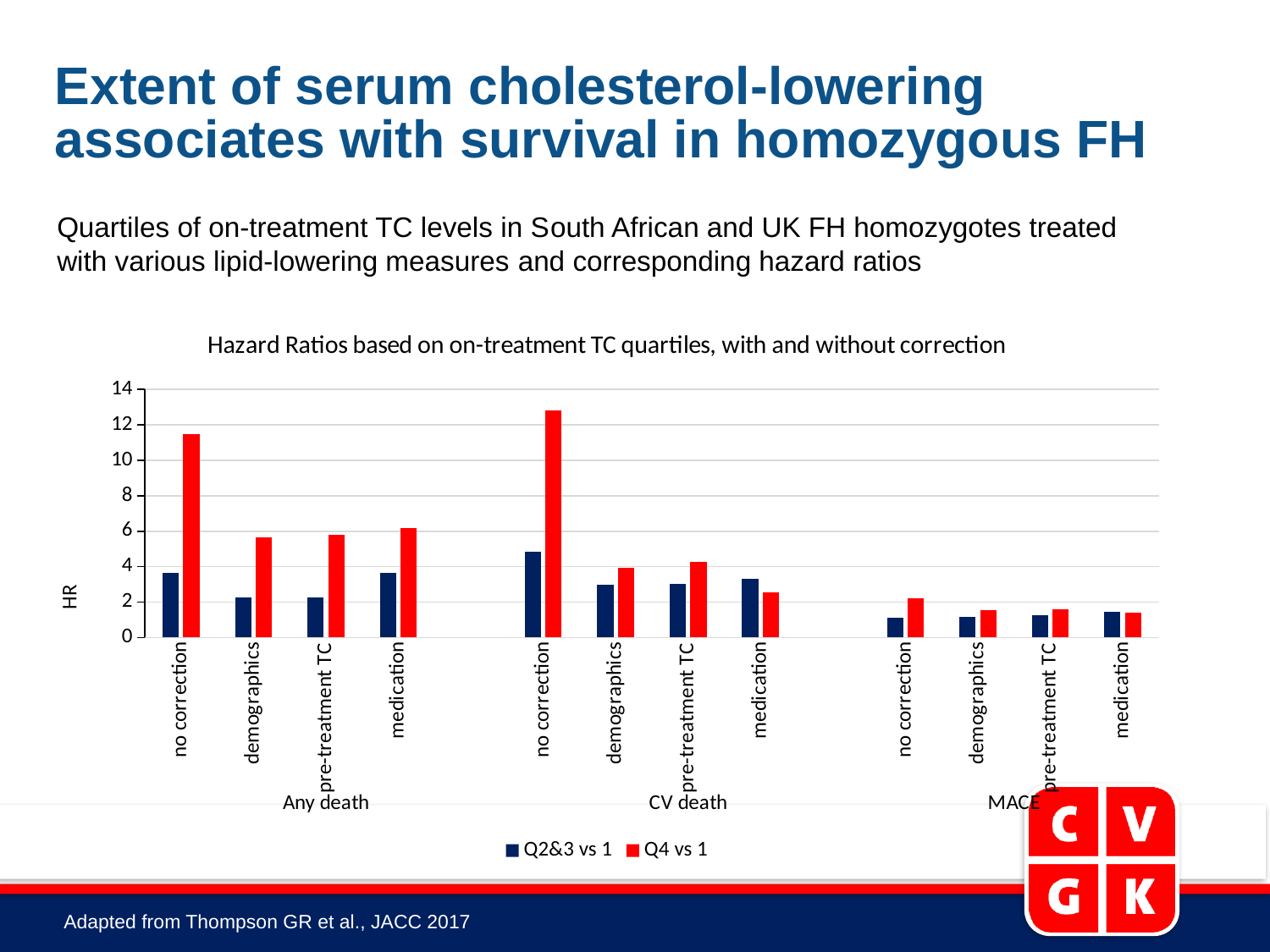
Is the Q4 vs 1 value for no correction under Any death greater or less than 10? greater What are the two series named in the legend? Q2&3 vs 1 and Q4 vs 1 Is the Q2&3 vs 1 value for no correction under CV death greater or less than 4? greater What is the title of the chart? Hazard Ratios based on on-treatment TC quartiles, with and without correction What kind of chart is shown on the slide? bar chart Is the Q4 vs 1 value for no correction under CV death greater or less than 12? greater How many series does the legend list? 2 For no correction under Any death, which series has the larger value, Q2&3 vs 1 or Q4 vs 1? Q4 vs 1 For medication under CV death, which series has the larger value, Q2&3 vs 1 or Q4 vs 1? Q2&3 vs 1 For which outcome and correction is the Q4 vs 1 bar the highest? CV death, no correction How many outcome groups are shown along the x axis? 3